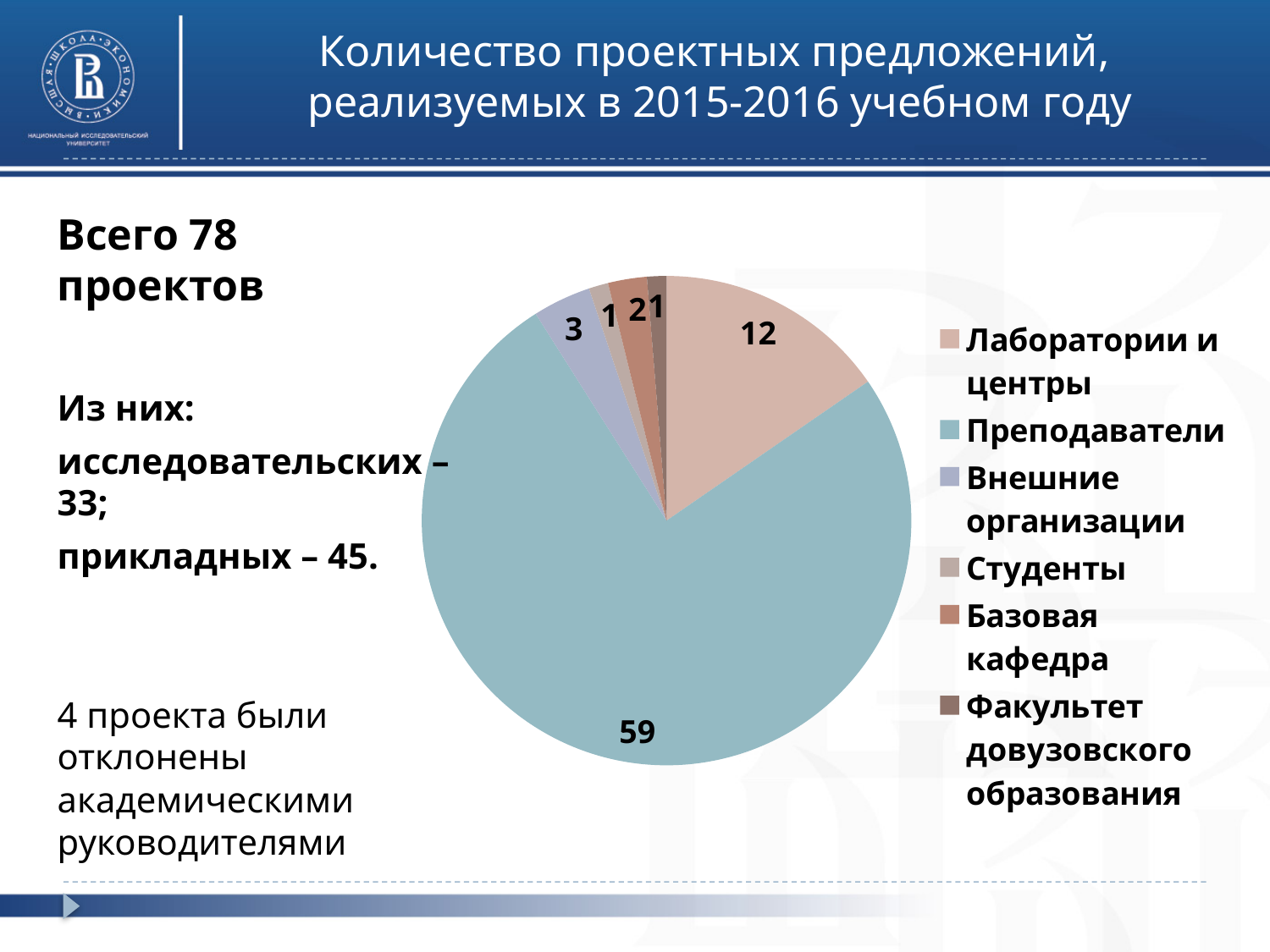
What type of chart is shown on the slide? pie chart Which legend entry is shown in the darkest brown colour? Факультет довузовского образования What is the total of all slices in the pie chart? 78 Which category has the largest slice in the pie chart? Преподаватели How many categories does the pie chart legend list? 6 What is the value for Базовая кафедра in the pie chart? 2 What is the difference between the values for Преподаватели and Лаборатории и центры? 47 What is the value for Внешние организации in the pie chart? 3 Which is larger: the value for Лаборатории и центры or the value for Внешние организации? Лаборатории и центры What is the value for Лаборатории и центры in the pie chart? 12 What is the difference between the values for Внешние организации and Базовая кафедра? 1 How many projects are attributed to Преподаватели in the pie chart? 59